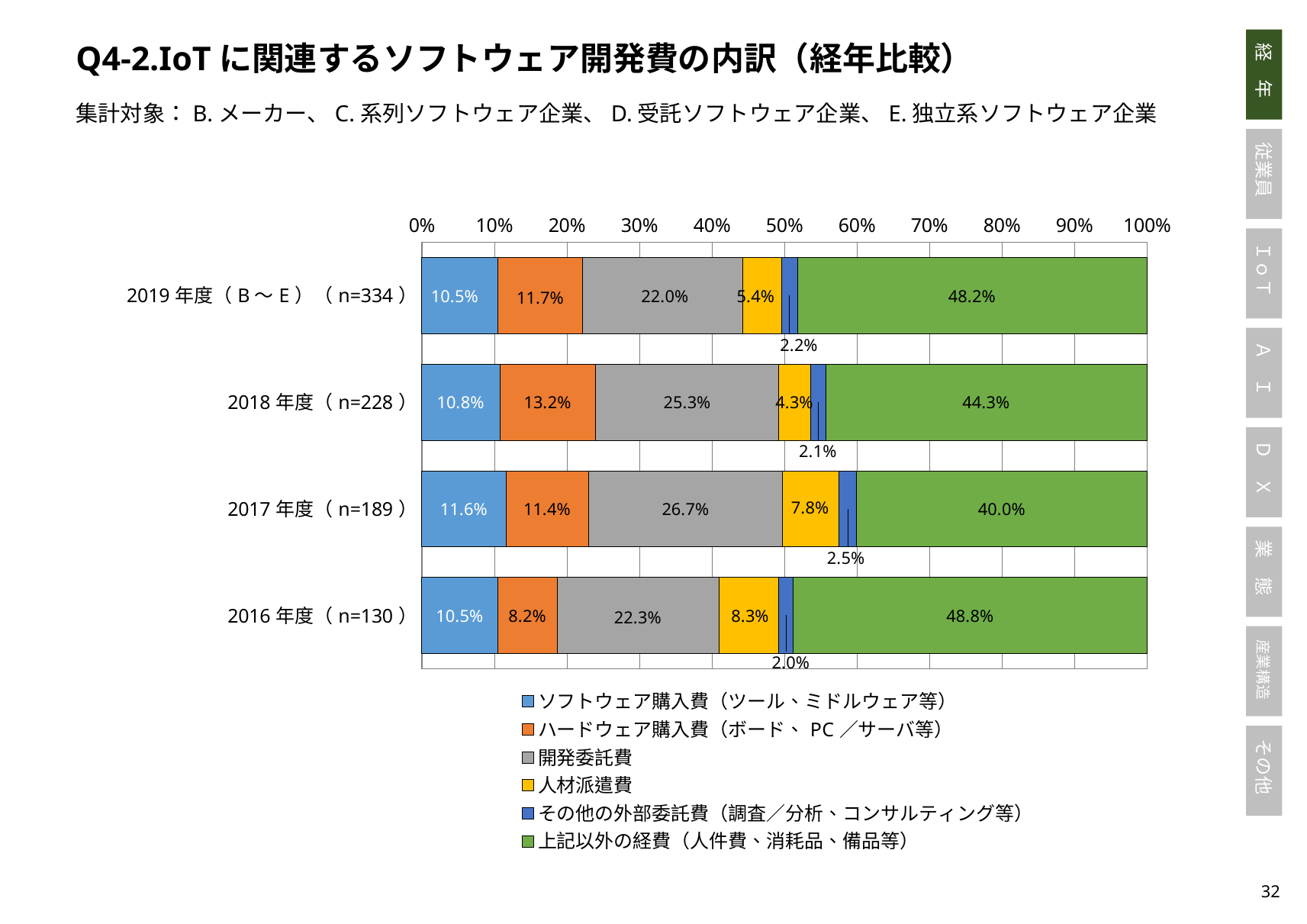
How many years (categories) are shown in the chart? 4 Which year has the lowest value for 人材派遣費? 2018年度 Which year has the highest value for 上記以外の経費? 2016年度 What kind of chart is shown on the slide? Stacked bar chart What is the value of 人材派遣費 for 2016年度? 8.3% What is the difference between the ハードウェア購入費 values for 2018年度 and 2019年度? 1.5 percentage points Does the value for 上記以外の経費 rise or fall from 2017年度 to 2019年度? Rise What is the sample size (n) shown for 2018年度? n=228 How many series does the legend list? 6 Which is larger, the ソフトウェア購入費 value for 2017年度 or for 2018年度? 2017年度 What is the value of 開発委託費 for 2019年度? 22.0% What is the value of その他の外部委託費 for 2017年度? 2.5%